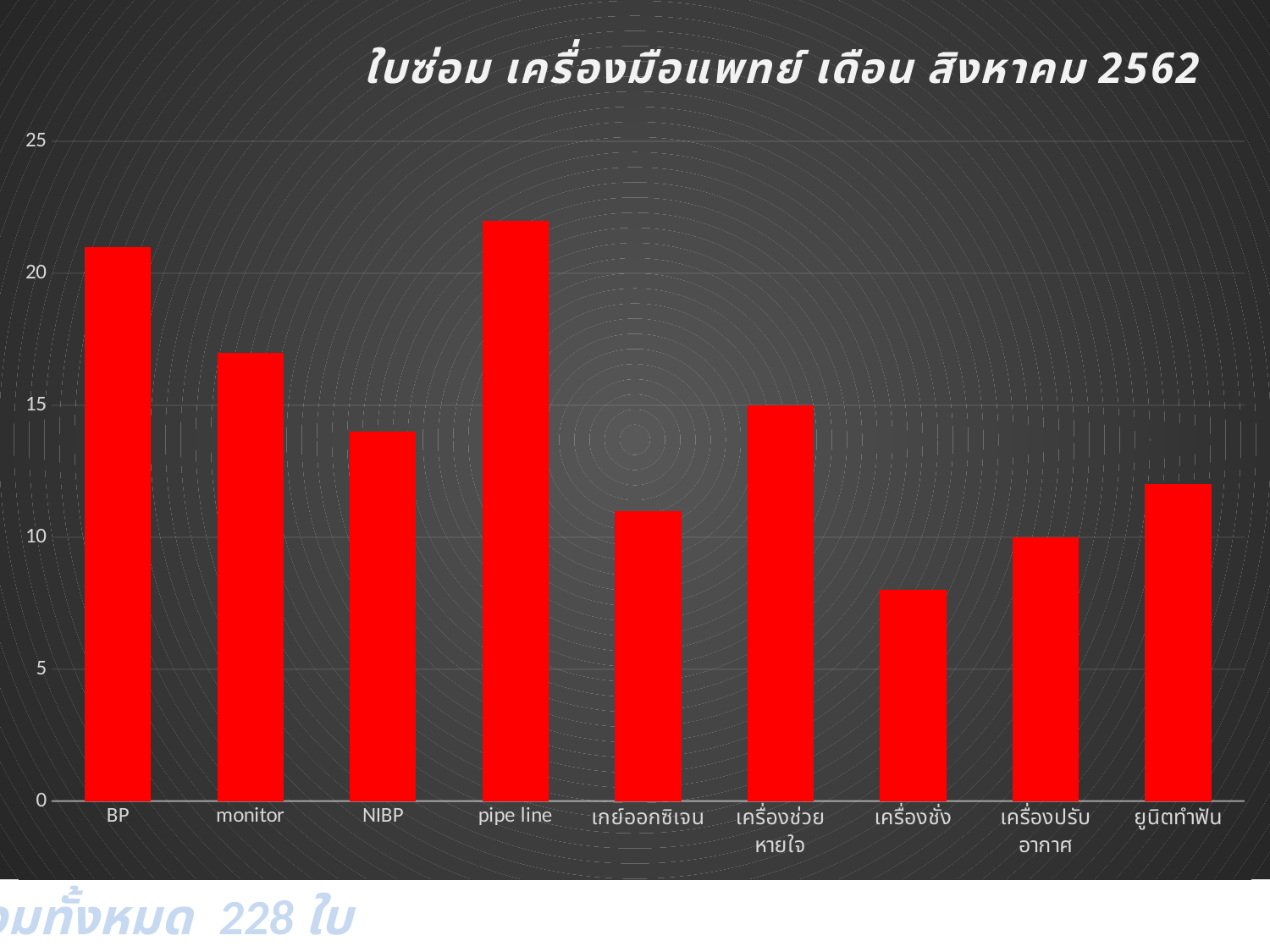
Is the value for monitor greater or less than 15? greater Which is larger, the value for monitor or the value for NIBP? monitor Which category has the lowest bar in the chart? เครื่องชั่ง Is the value for NIBP greater or less than 15? less Is the value for ยูนิตทำฟัน greater or less than 10? greater How many categories are shown on the x axis of the chart? 9 Which is larger, the value for เกย์ออกซิเจน or the value for เครื่องช่วยหายใจ? เครื่องช่วยหายใจ What is the title of the chart? ใบซ่อม เครื่องมือแพทย์ เดือน สิงหาคม 2562 What kind of chart is shown on the slide? bar chart Which category has the highest bar in the chart? pipe line